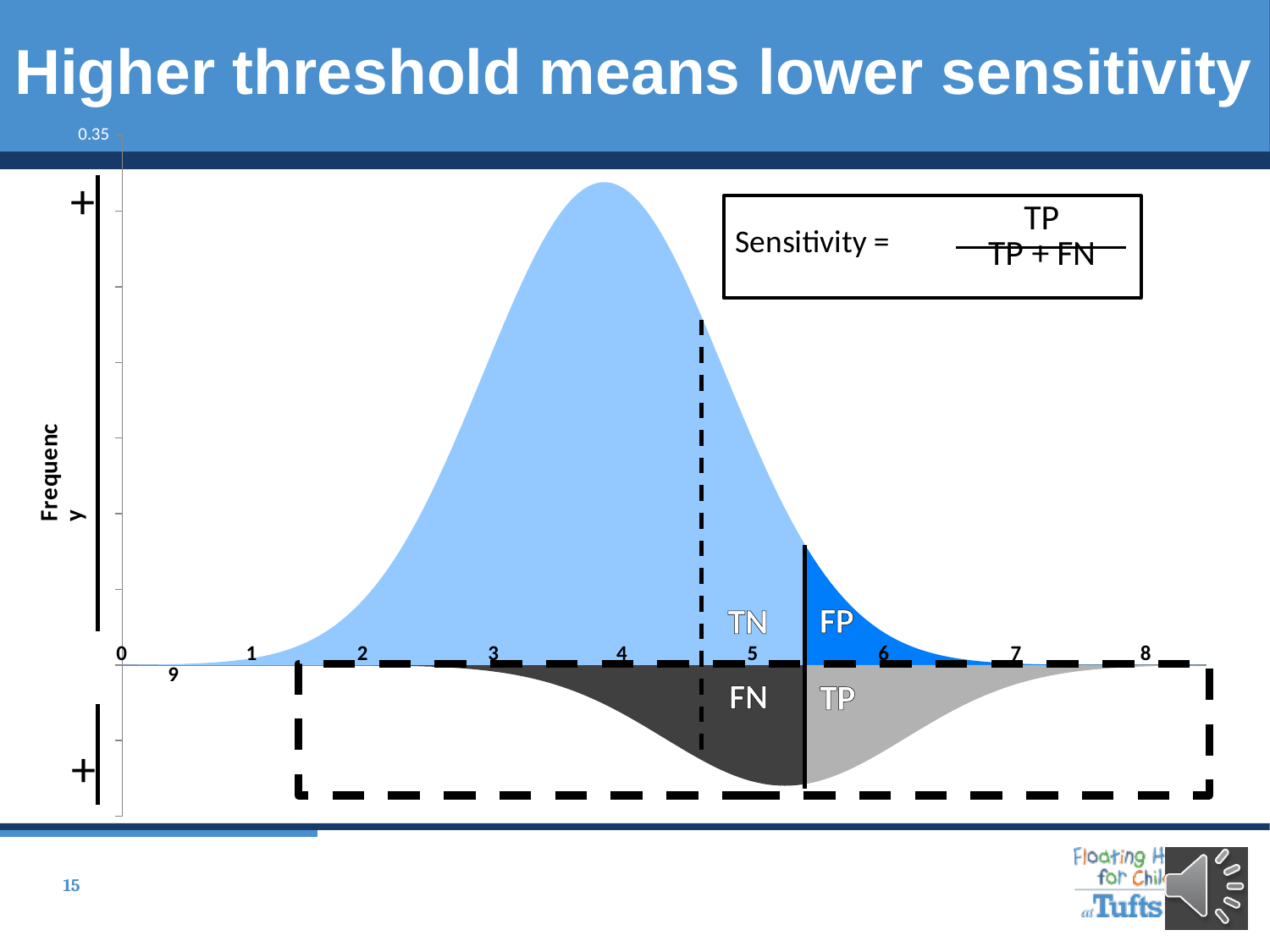
What is the lowest value printed on the x-axis? 0 What is the highest value printed on the y-axis? 0.35 Between which two x-axis ticks does the solid vertical threshold line fall? 5 and 6 What is the label on the y-axis of the chart? Frequency Which x-axis tick is the peak of the upper curve closest to? 4 Does the upper curve rise or fall as x goes from 5 to 7? Fall Which region label appears in the light grey area below the axis, to the right of the threshold line? TP Does the upper curve rise or fall as x goes from 1 to 4? Rise Which region label is shown in the dark blue shaded area to the right of the threshold line above the axis? FP What kind of chart is shown on the slide? Area chart Which region label appears in the dark grey area below the axis, to the left of the threshold line? FN